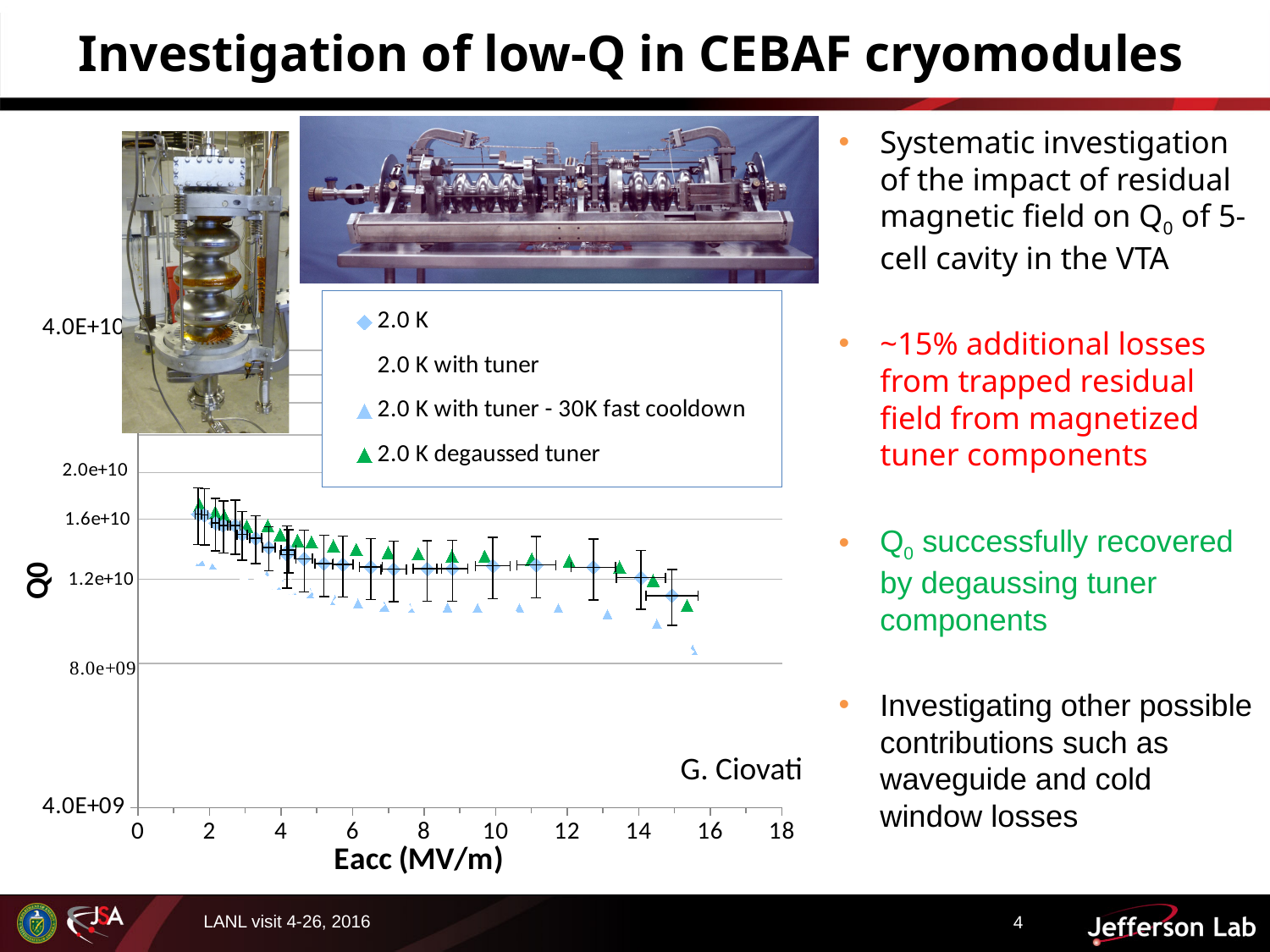
How many series does the chart's legend list? 4 What is the highest tick value shown on the x axis of the chart? 18 Is the Q0 value for the '2.0 K with tuner - 30K fast cooldown' series at Eacc of about 10 MV/m greater or less than 1.2e+10? less What is the lowest tick value shown on the y axis of the chart? 4.0E+09 What kind of chart is shown on the slide? scatter chart At Eacc of about 8 MV/m, which series has the higher Q0: '2.0 K degaussed tuner' or '2.0 K with tuner - 30K fast cooldown'? 2.0 K degaussed tuner What is the label of the y axis of the chart? Q0 What is the label of the x axis of the chart? Eacc (MV/m) Do the Q0 values rise or fall as Eacc increases along the x axis? fall Is the Q0 value for the '2.0 K degaussed tuner' series at Eacc of about 14 MV/m greater or less than 8.0e+09? greater Is the Q0 value for the '2.0 K degaussed tuner' series at Eacc of about 2 MV/m greater or less than 1.2e+10? greater